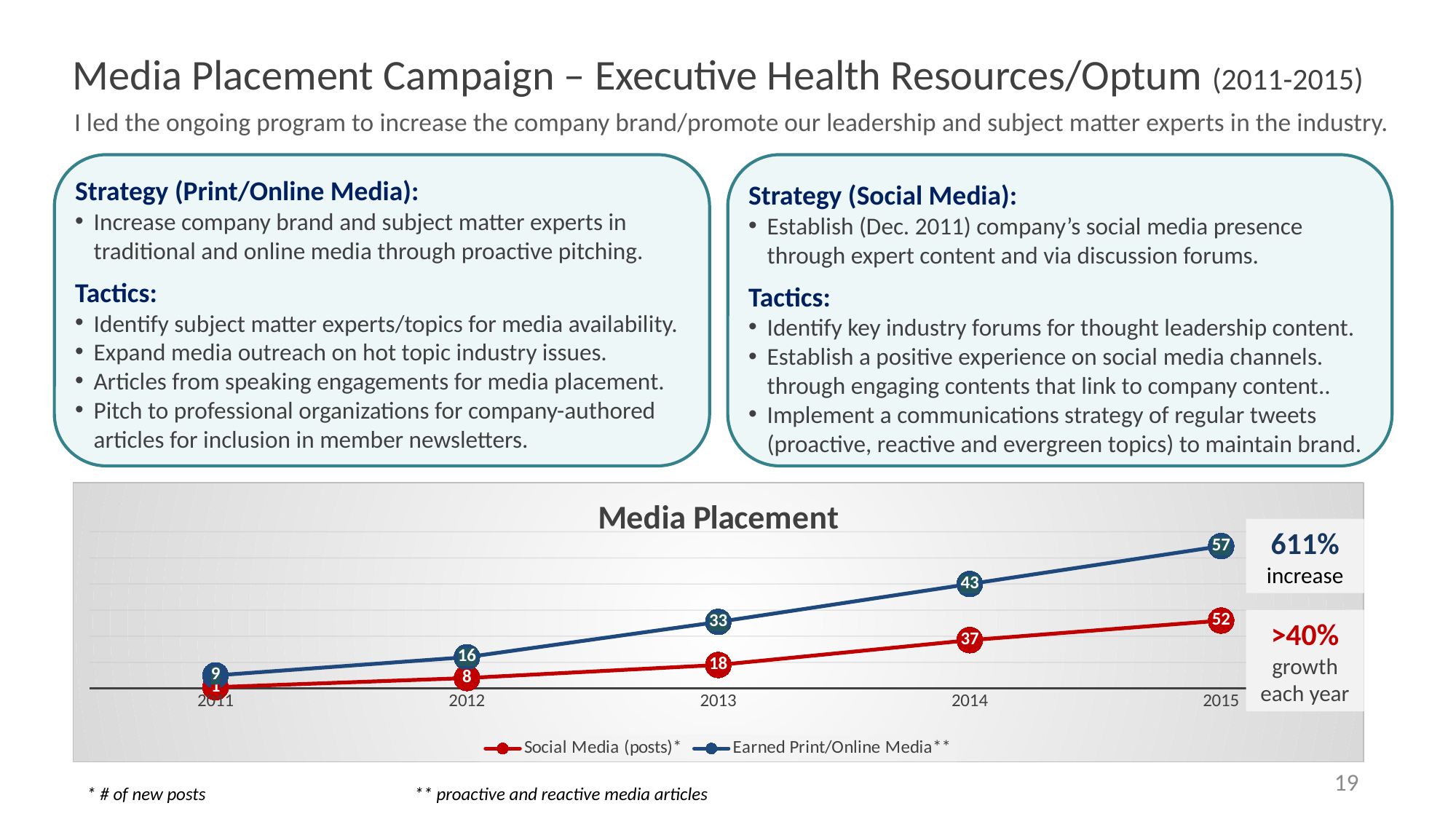
What is the difference between Earned Print/Online Media and Social Media (posts) in 2013? 15 What is the value for Social Media (posts) in 2014? 37 Do the Social Media (posts) values rise or fall from 2011 to 2015? rise What is the value for Social Media (posts) in 2012? 8 What is the value for Earned Print/Online Media in 2015? 57 In which year is Social Media (posts) lowest? 2011 In which year is Earned Print/Online Media highest? 2015 How many series does the legend of the Media Placement chart list? 2 What is the value for Earned Print/Online Media in 2013? 33 Which series has the larger value in 2014, Social Media (posts) or Earned Print/Online Media? Earned Print/Online Media What type of chart is the Media Placement chart? line chart How many years are plotted on the x axis of the Media Placement chart? 5